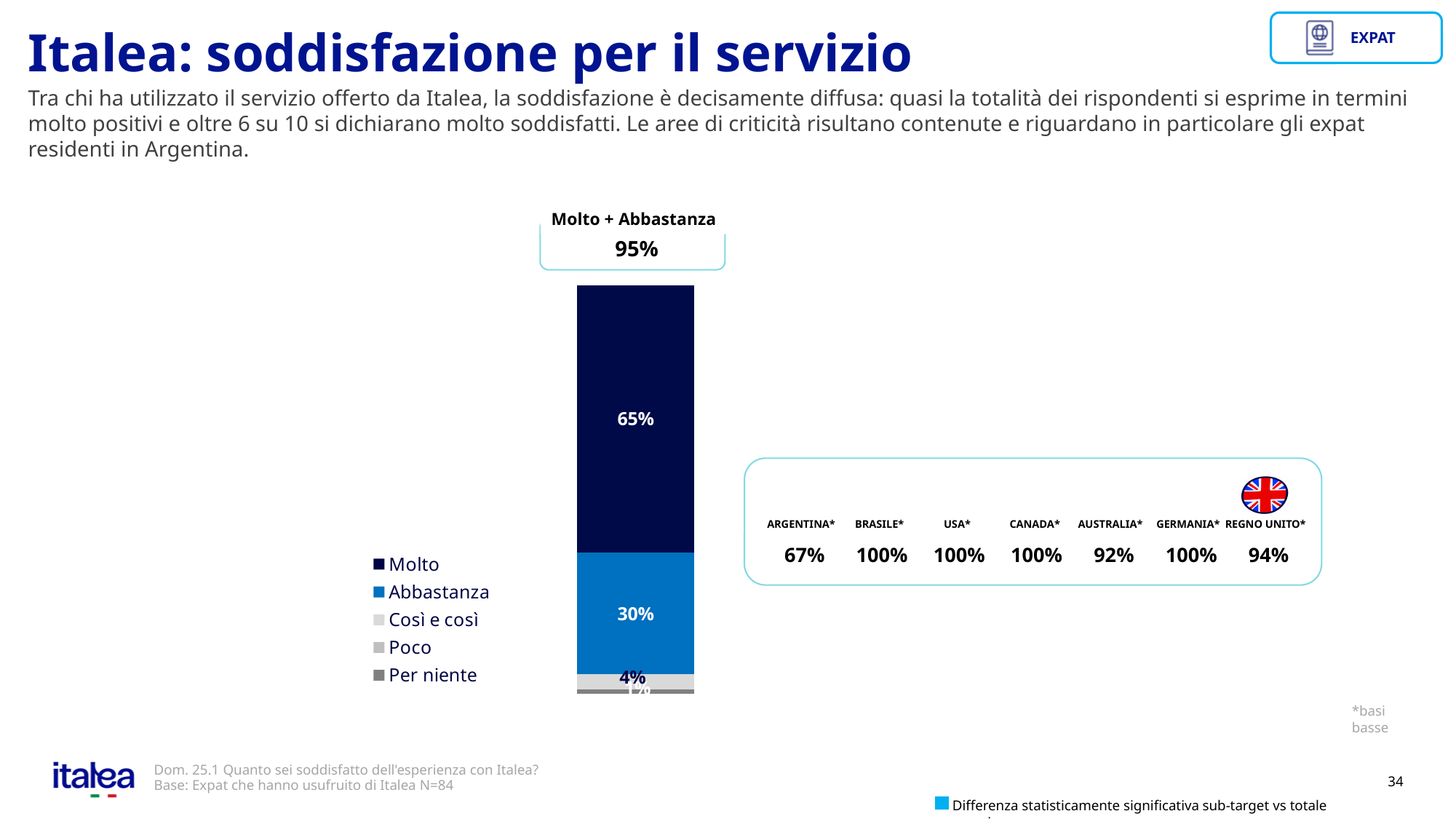
What percentage of respondents answered "Molto" in the stacked bar? 65% In the country box next to the chart, what is the value shown for Argentina? 67% Which segment is larger, "Abbastanza" or "Così e così"? Abbastanza What is the difference between the "Molto" and "Abbastanza" segments? 35% What kind of chart is shown on the slide? stacked bar chart What percentage of respondents answered "Abbastanza" in the stacked bar? 30% Which response category has the largest segment in the stacked bar? Molto In the country box next to the chart, which country has the lowest value? Argentina How many response categories does the legend list? 5 What is the combined value shown for "Molto + Abbastanza"? 95% Which legend entry is shown in the darkest blue colour? Molto What percentage of respondents answered "Così e così" in the stacked bar? 4%